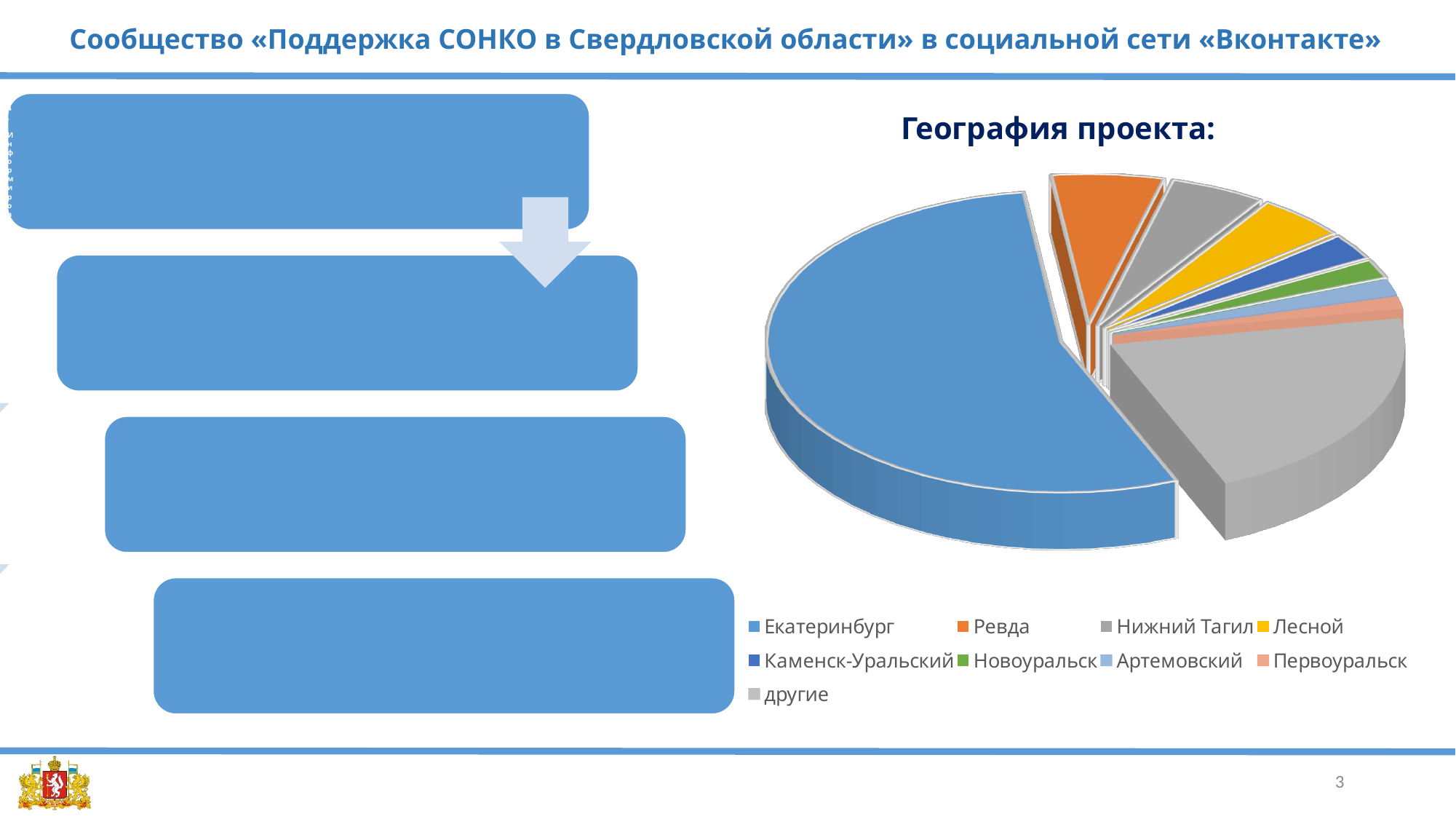
In the «География проекта:» pie chart, which slice is larger: Нижний Тагил or Каменск-Уральский? Нижний Тагил What is the title of the pie chart on the slide? География проекта: How many categories does the legend of the «География проекта:» pie chart list? 9 In the «География проекта:» pie chart, which slice is larger: Ревда or Новоуральск? Ревда What kind of chart is shown under the title «География проекта:»? pie chart Which colour represents Ревда in the «География проекта:» pie chart? orange In the «География проекта:» pie chart, which slice is larger: Екатеринбург or Ревда? Екатеринбург Which category has the largest slice in the «География проекта:» pie chart? Екатеринбург